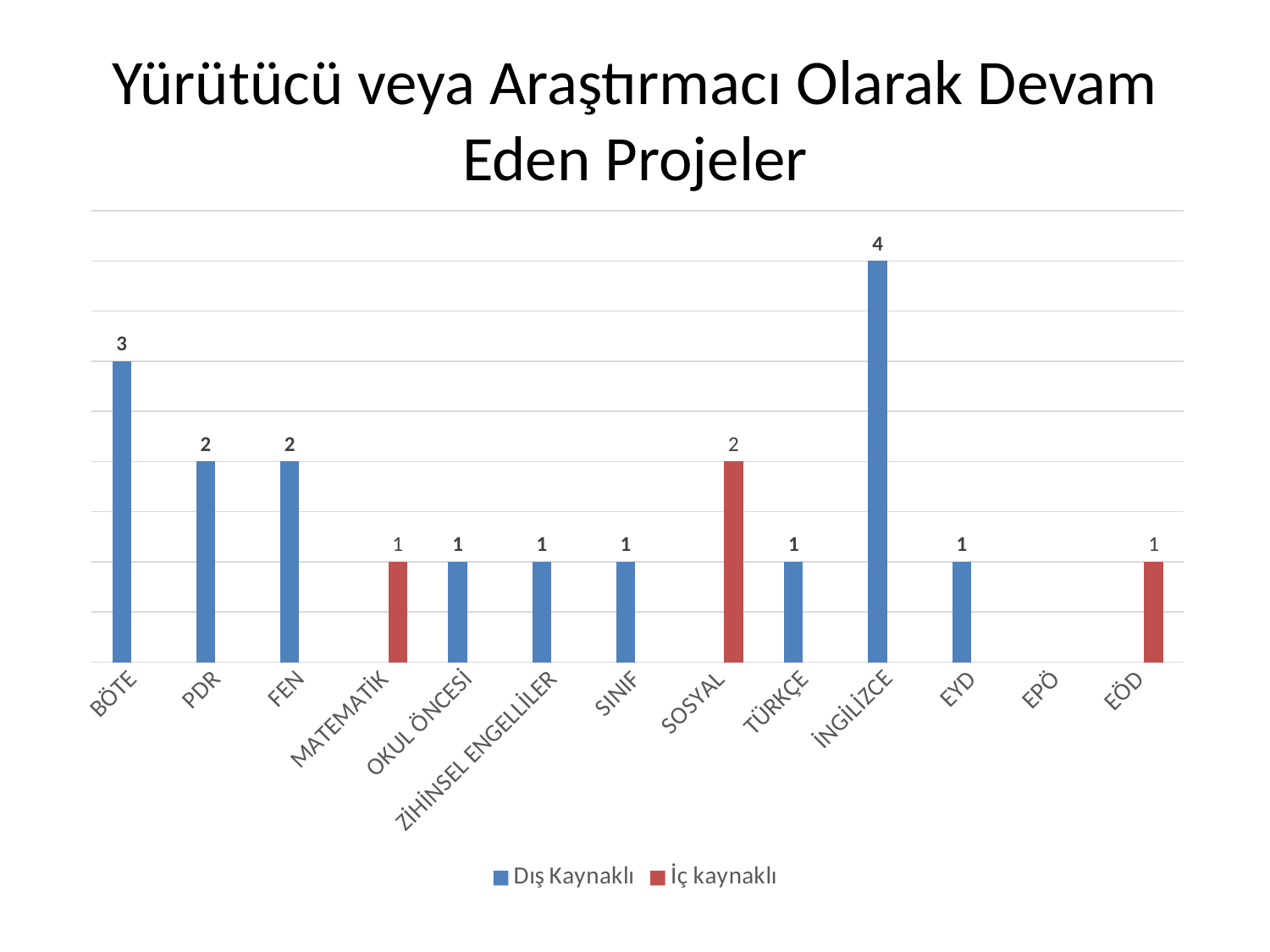
What is the Dış Kaynaklı value for İNGİLİZCE? 4 What is the İç kaynaklı value for SOSYAL? 2 What is the Dış Kaynaklı value for BÖTE? 3 What is the title of the chart? Yürütücü veya Araştırmacı Olarak Devam Eden Projeler What kind of chart is shown on the slide? Bar chart Which series is shown in red in the legend? İç kaynaklı How many series does the legend list? 2 What is the difference between the İNGİLİZCE value and the BÖTE value? 1 How many categories are shown on the x axis? 13 Which category has the highest value in the chart? İNGİLİZCE What is the İç kaynaklı value for MATEMATİK? 1 Which is larger, the value for PDR or the value for TÜRKÇE? PDR